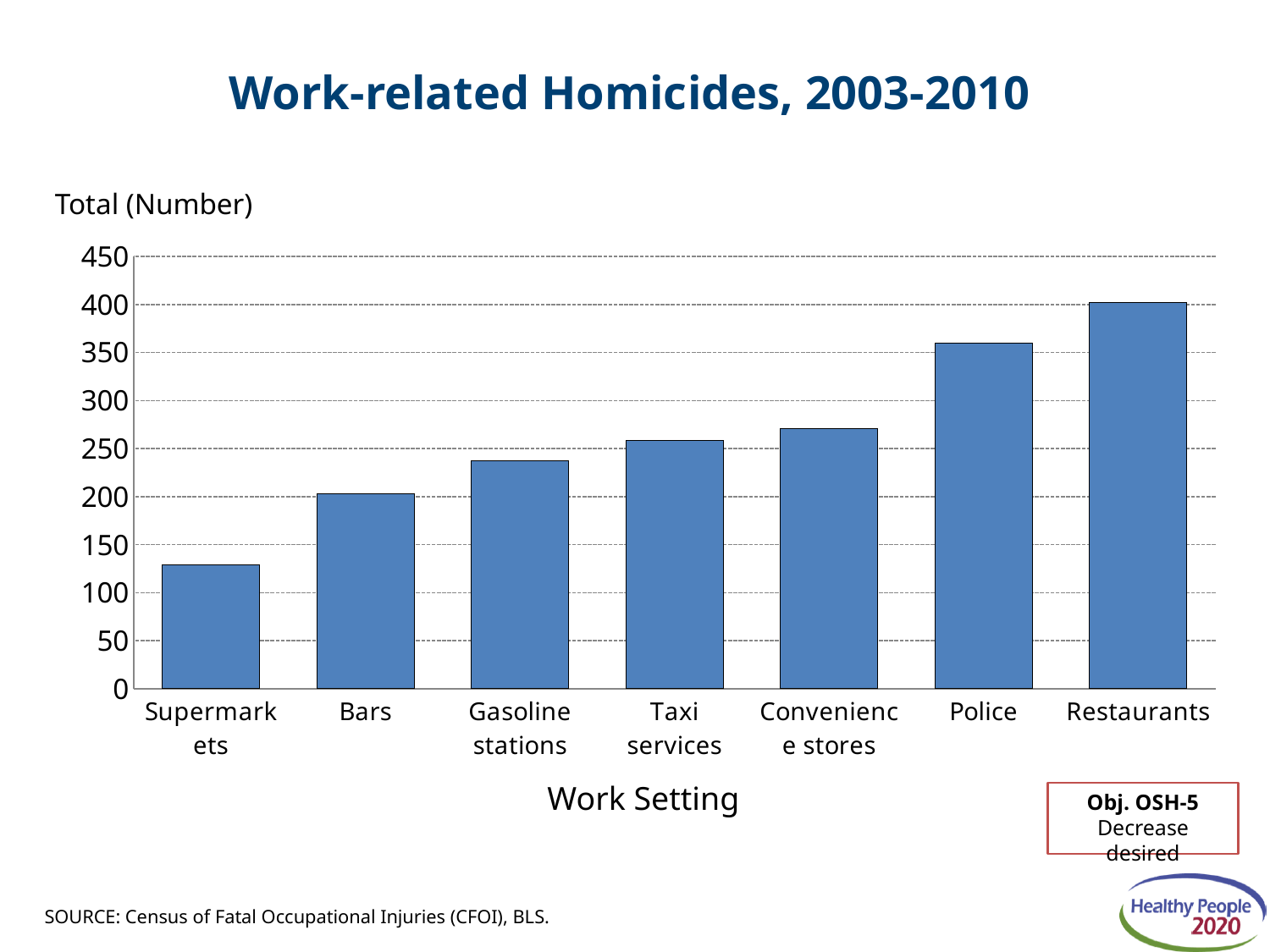
What is the title of the chart? Work-related Homicides, 2003-2010 What kind of chart is shown on the slide? bar chart Is the value for Supermarkets greater or less than 150? less Which work setting has the lowest number of work-related homicides? Supermarkets How many work settings are shown on the chart? 7 Is the value for Police greater or less than 400? less Is the value for Convenience stores greater or less than 250? greater Do the values rise or fall moving from left to right across the work settings? rise Which work setting has the highest number of work-related homicides? Restaurants Which has more work-related homicides, Police or Convenience stores? Police